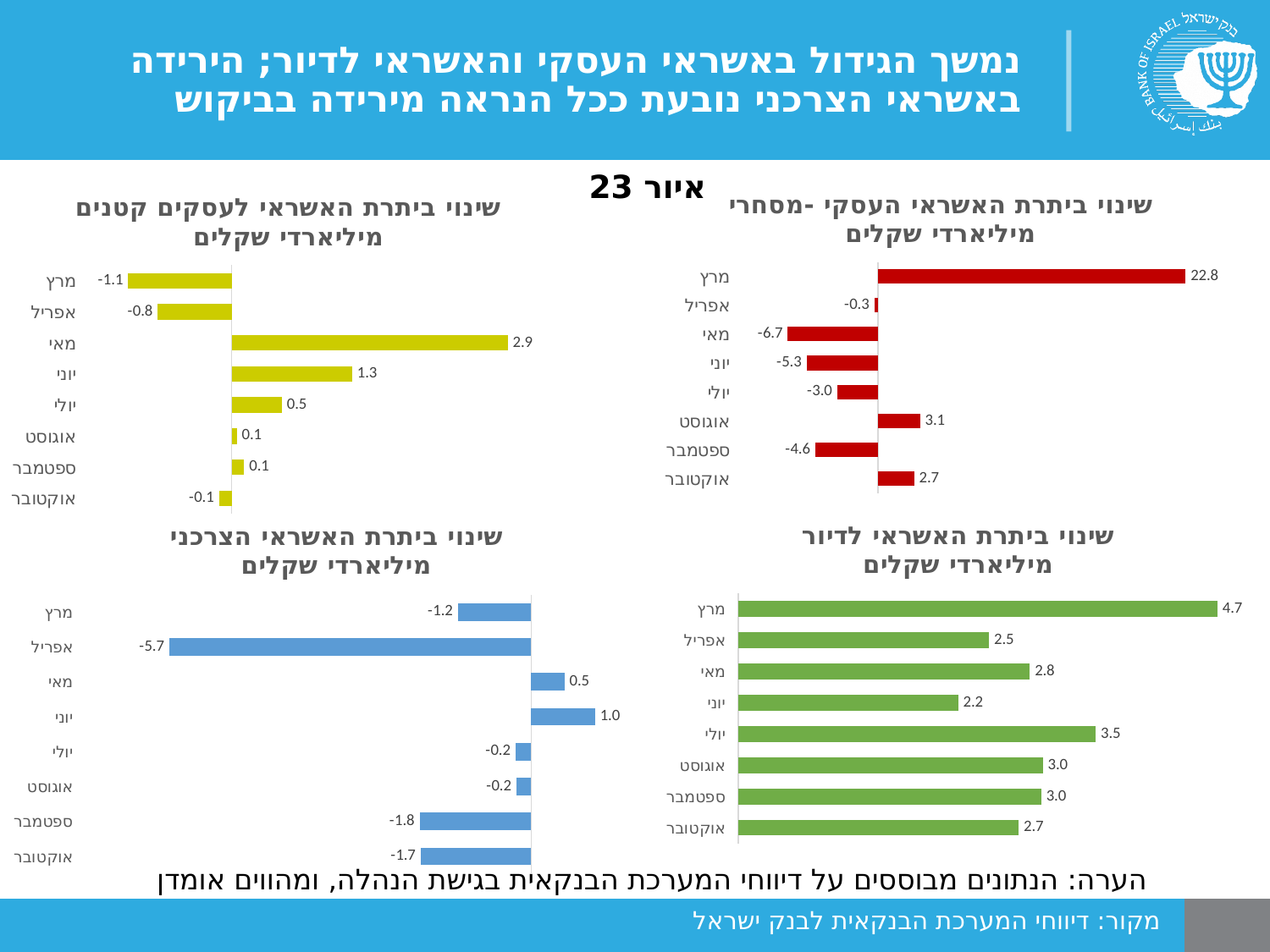
What type of chart is the bottom-right chart (housing credit)? Bar chart In the bottom-right chart (housing credit, שינוי ביתרת האשראי לדיור), which month has the highest value? מרץ (March) In the top-right chart (business-commercial credit), which month has the lowest value? מאי (May) In the bottom-right chart (housing credit), what is the value for July (יולי)? 3.5 In the top-left chart (credit to small businesses, שינוי ביתרת האשראי לעסקים קטנים), which month has the highest value? מאי (May) In the bottom-left chart (consumer credit, שינוי ביתרת האשראי הצרכני), what is the value for April (אפריל)? -5.7 In the bottom-left chart (consumer credit), how many months are plotted? 8 In the bottom-right chart (housing credit), which is larger: the value for April (אפריל) or the value for May (מאי)? מאי (May) In the top-right chart (business-commercial credit, שינוי ביתרת האשראי העסקי-מסחרי), what is the value for March (מרץ)? 22.8 In the top-right chart (business-commercial credit), what is the value for September (ספטמבר)? -4.6 In the top-left chart (credit to small businesses), what is the difference between the May (מאי) and June (יוני) values? 1.6 In the top-left chart (credit to small businesses), what is the value for June (יוני)? 1.3